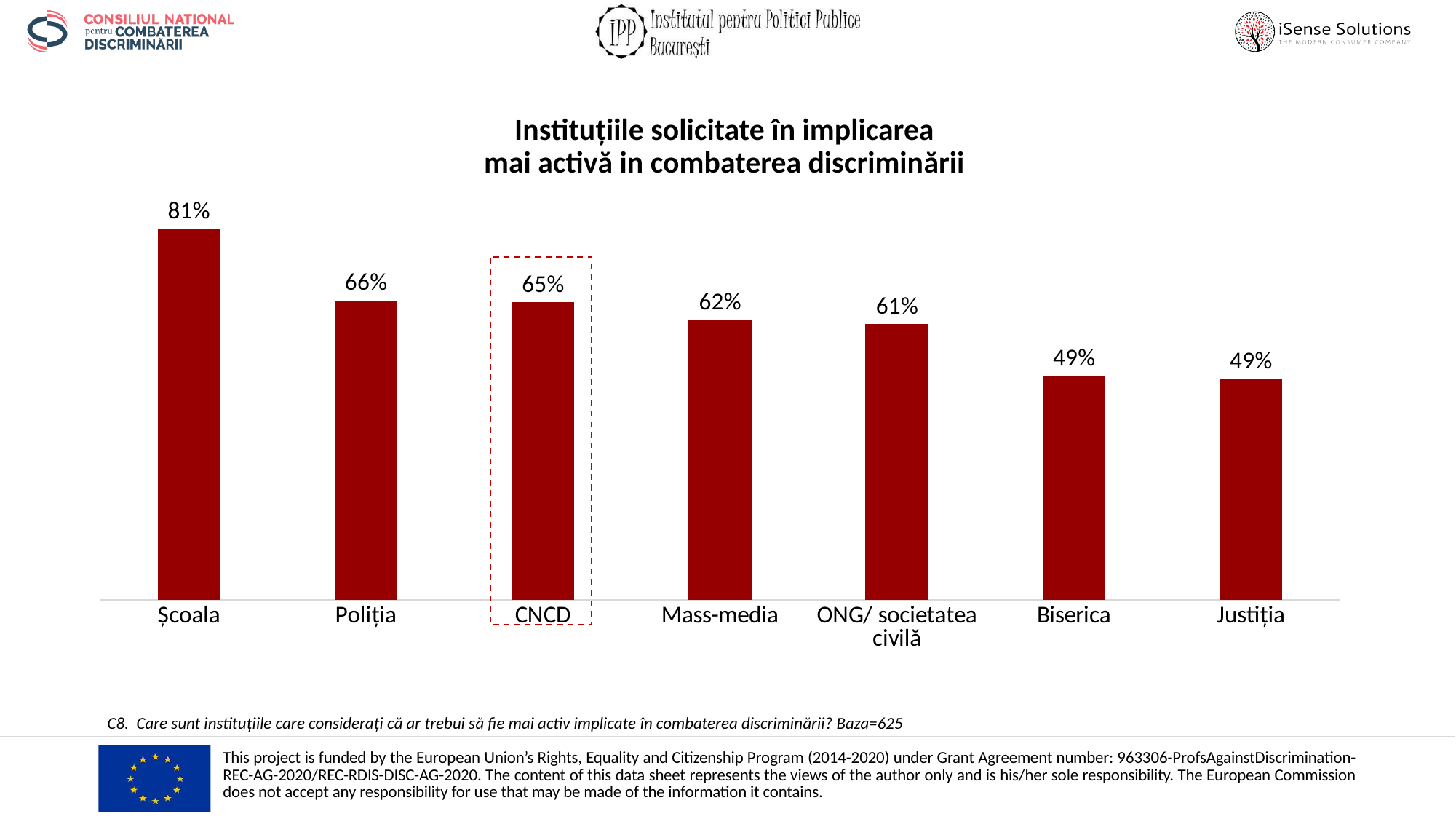
What is the value for CNCD? 65% How many categories are shown in the chart? 7 What is the difference between the values for CNCD and Biserica? 16% Which category is highlighted with a dashed red outline? CNCD What is the value for Școala? 81% Which category has the highest value? Școala What is the value for Mass-media? 62% What is the difference between the values for Școala and Poliția? 15% Which is larger, the value for Poliția or the value for Justiția? Poliția What kind of chart is shown on the slide? bar chart What is the value for ONG/ societatea civilă? 61% Do the values rise or fall from left to right along the x axis? fall